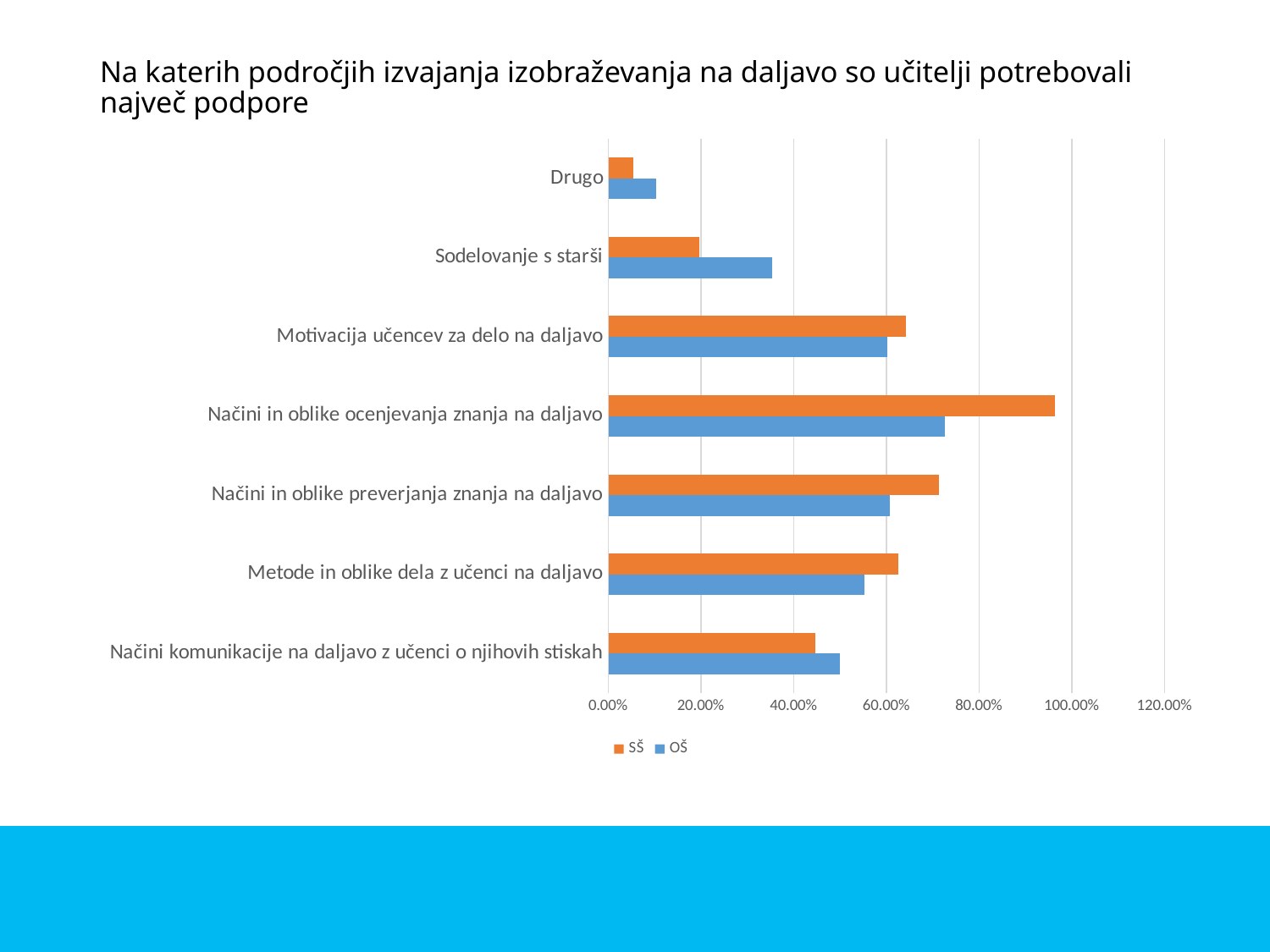
Is the OŠ value for Sodelovanje s starši greater or less than 40.00%? less Which category has the lowest value for the OŠ series? Drugo Which category has the highest value for the SŠ series? Načini in oblike ocenjevanja znanja na daljavo How many categories are shown on the chart? 7 Which colour represents the OŠ series in the legend? blue Is the SŠ value for Načini in oblike ocenjevanja znanja na daljavo greater or less than 80.00%? greater Which category has the highest value for the OŠ series? Načini in oblike ocenjevanja znanja na daljavo For Načini in oblike preverjanja znanja na daljavo, which series has the larger value, SŠ or OŠ? SŠ For Sodelovanje s starši, which series has the larger value, SŠ or OŠ? OŠ What kind of chart is shown on the slide? bar chart Is the SŠ value for Drugo greater or less than 20.00%? less How many series does the legend list? 2